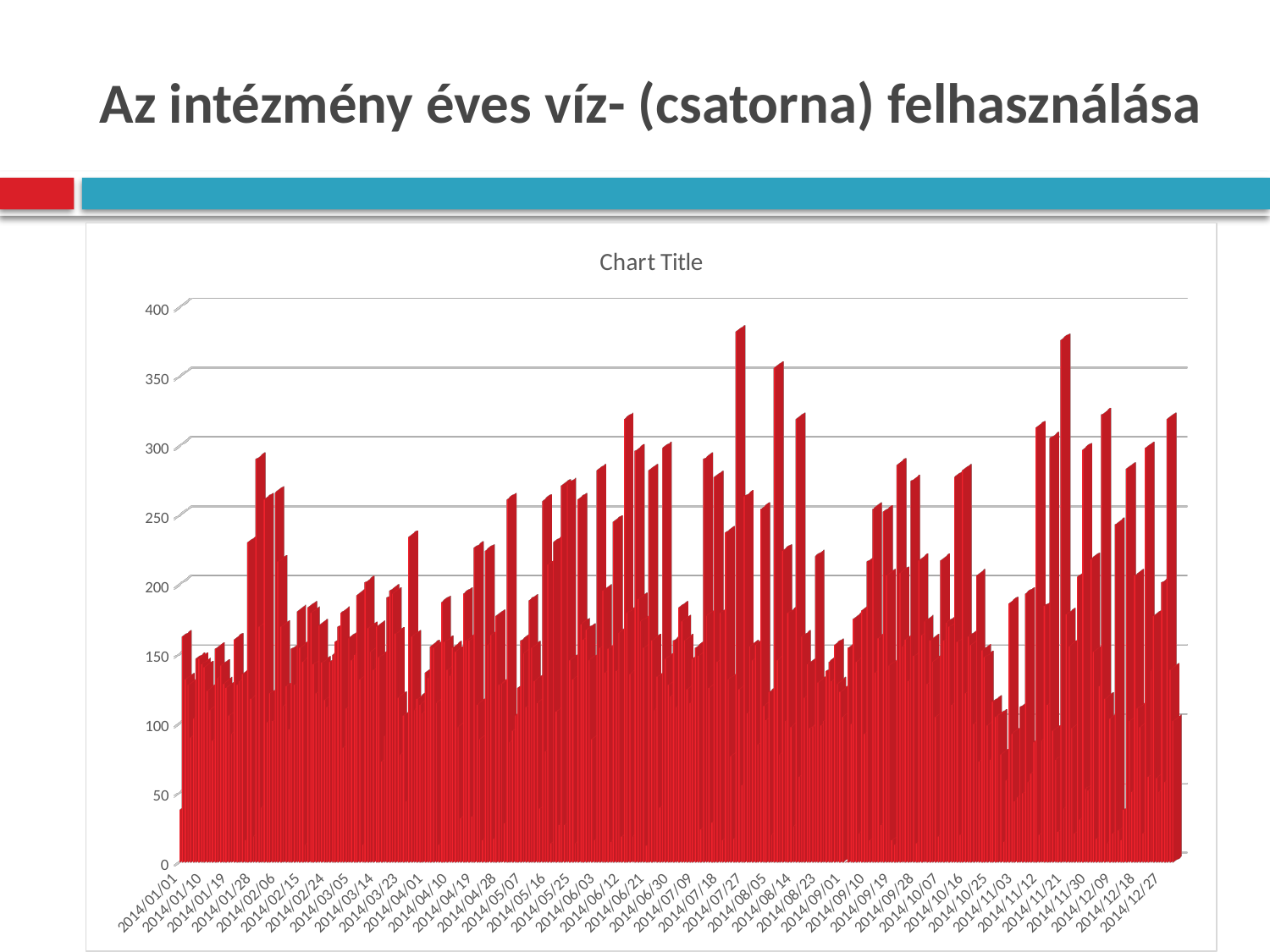
Is the highest bar in the chart greater or less than 350? greater What is the highest value shown on the vertical axis of the chart? 400 Is the value for the first bar, at 2014/01/01, greater or less than 100? less What is the title printed above the chart? Chart Title What kind of chart is shown on the slide? bar chart Is the highest bar in the chart greater or less than 400? less